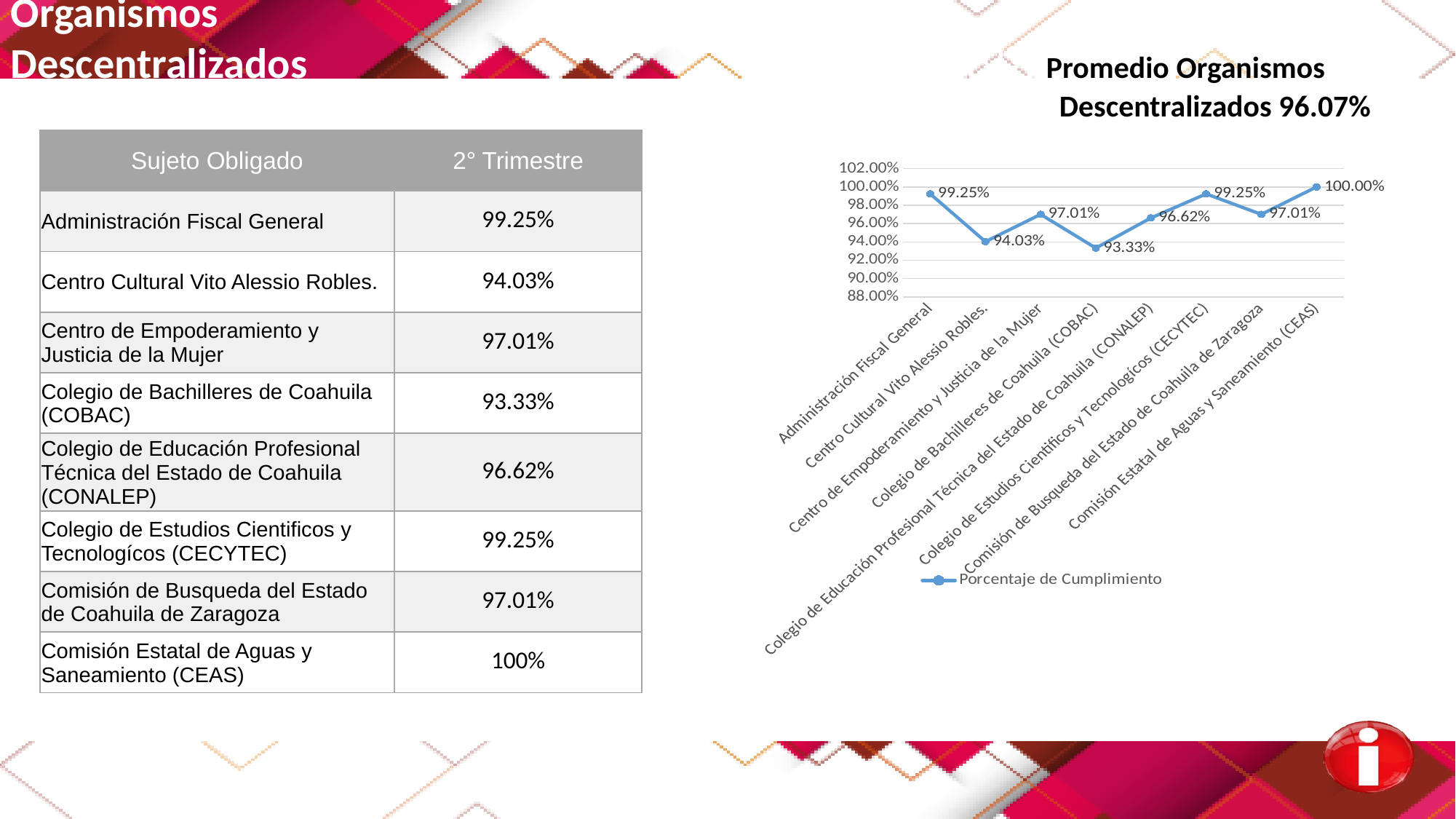
What is the value for Comisión Estatal de Aguas y Saneamiento (CEAS) in the chart? 100.00% What is the name of the series shown in the chart legend? Porcentaje de Cumplimiento Which category has the highest value in the chart? Comisión Estatal de Aguas y Saneamiento (CEAS) What type of chart is shown on the slide? Line chart How many series does the chart legend list? 1 What is the value for Centro Cultural Vito Alessio Robles. in the chart? 94.03% Which category has the lowest value in the chart? Colegio de Bachilleres de Coahuila (COBAC) How many categories are plotted on the x axis of the chart? 8 What is the value for Colegio de Bachilleres de Coahuila (COBAC) in the chart? 93.33% Which is larger: the value for Centro de Empoderamiento y Justicia de la Mujer or the value for Colegio de Educación Profesional Técnica del Estado de Coahuila (CONALEP)? Centro de Empoderamiento y Justicia de la Mujer What is the difference between the value for Comisión Estatal de Aguas y Saneamiento (CEAS) and the value for Colegio de Bachilleres de Coahuila (COBAC)? 6.67% What is the value for Administración Fiscal General in the chart? 99.25%